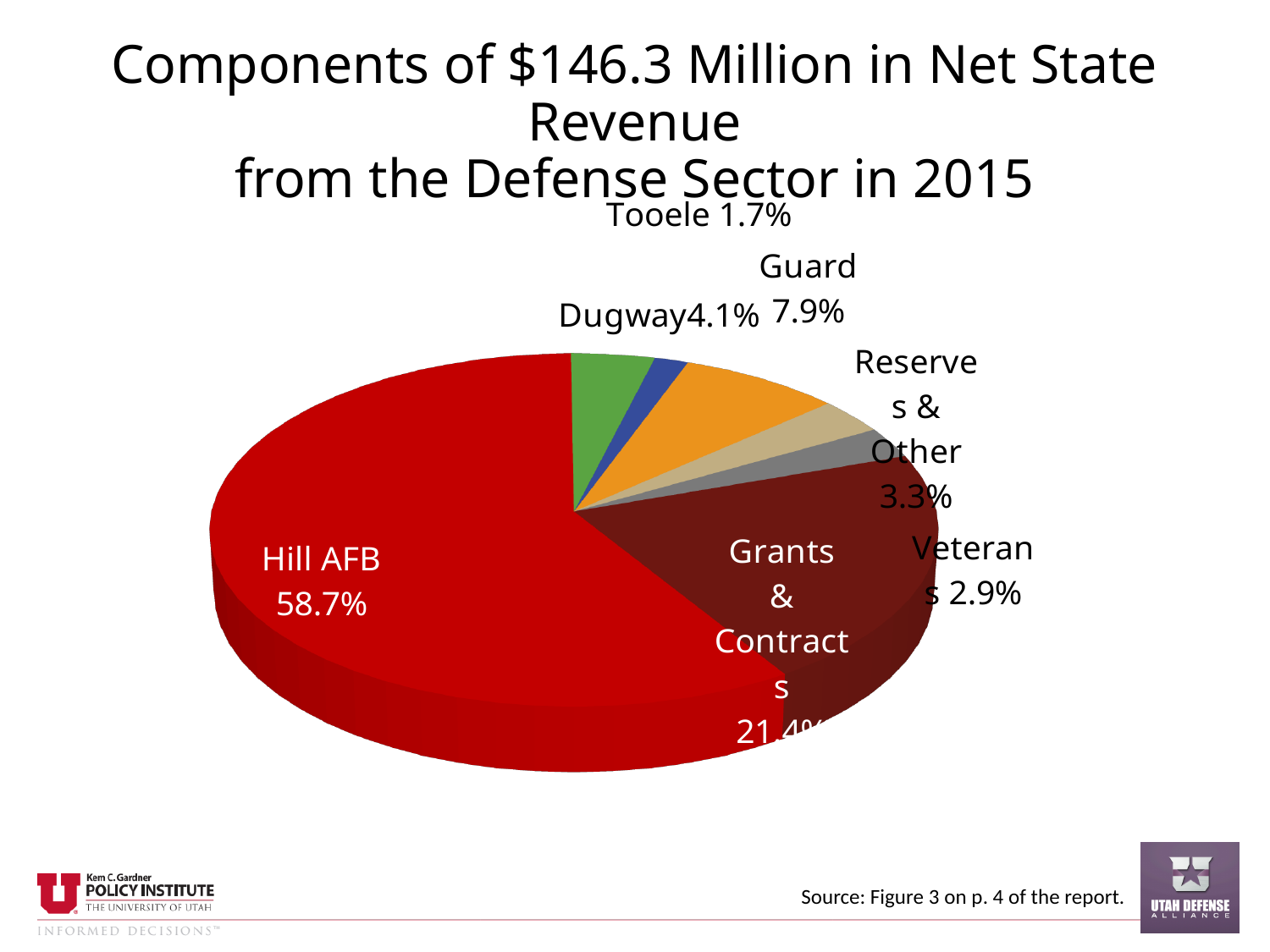
How many components (slices) are shown in the pie chart? 7 Which has a larger share, Guard or Dugway? Guard What share of net state revenue comes from Grants & Contracts? 21.4% What is the difference in percentage points between Hill AFB and Grants & Contracts? 37.3 percentage points Which component accounts for the smallest share of net state revenue? Tooele What share of net state revenue comes from Tooele? 1.7% What share of net state revenue comes from Dugway? 4.1% What share of net state revenue comes from the Guard? 7.9% What type of chart is shown on the slide? Pie chart What share of net state revenue comes from Hill AFB? 58.7% Which component accounts for the largest share of net state revenue? Hill AFB What total amount of net state revenue does the chart title say the components make up? $146.3 Million